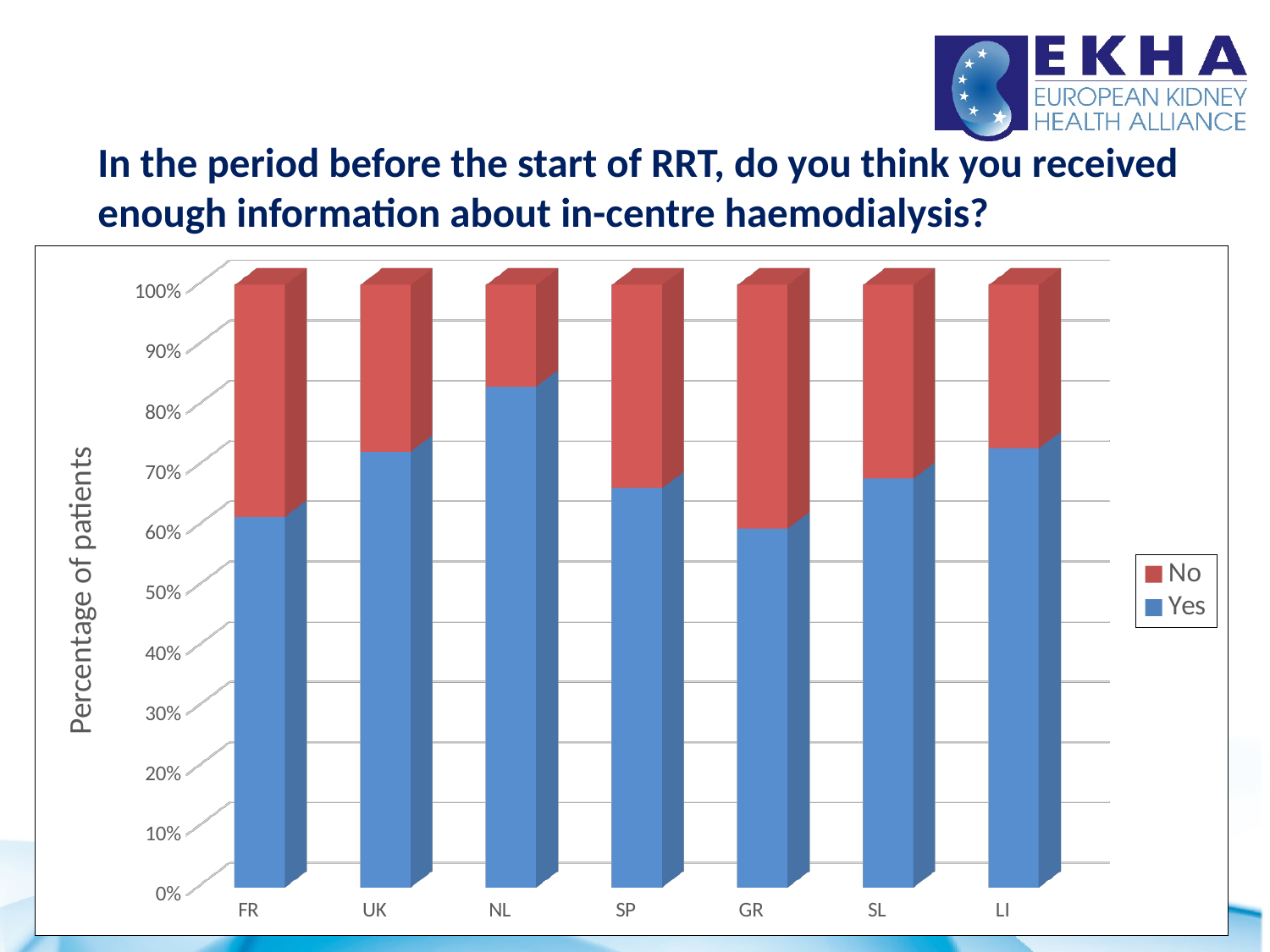
What kind of chart is shown on the slide? bar chart Which country has a larger No share, FR or NL? FR Which country has a larger Yes share, UK or SP? UK Is the Yes share for FR greater or less than 50%? greater What is the total height of each stacked bar in the chart? 100% How many countries are shown on the x axis of the chart? 7 Which colour represents the Yes series in the chart? blue Which country has the highest share of patients answering Yes? NL What is the label on the vertical axis of the chart? Percentage of patients Is the Yes share for NL greater or less than 80%? greater Is the Yes share for GR greater or less than 70%? less How many series does the chart's legend list? 2